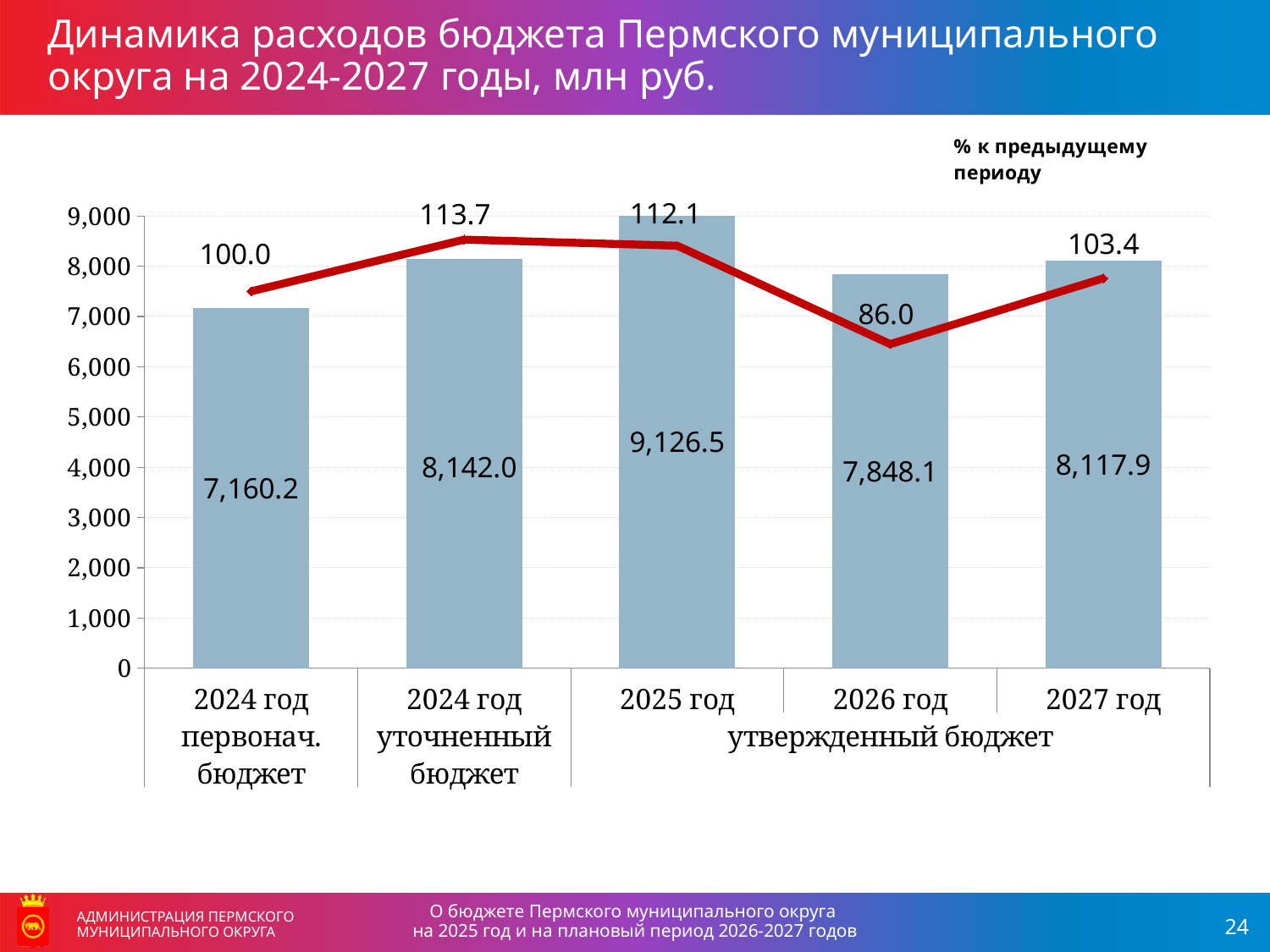
What is the value for 2027 год? 8,117.9 What is the '% к предыдущему периоду' value for 2024 год уточненный бюджет? 113.7 Which category has the lowest bar value? 2024 год первонач. бюджет What is the '% к предыдущему периоду' value for 2026 год? 86.0 What is the title of the chart? Динамика расходов бюджета Пермского муниципального округа на 2024-2027 годы, млн руб. Which is larger, the bar value for 2024 год уточненный бюджет or for 2027 год? 2024 год уточненный бюджет How many bars are shown in the chart? 5 What is the value for 2024 год первонач. бюджет? 7,160.2 What is the budget expenditure value for 2025 год? 9,126.5 Which category has the highest bar value? 2025 год What is the difference between the bar values for 2025 год and 2026 год? 1,278.4 Do the bar values rise or fall from 2025 год to 2026 год? fall